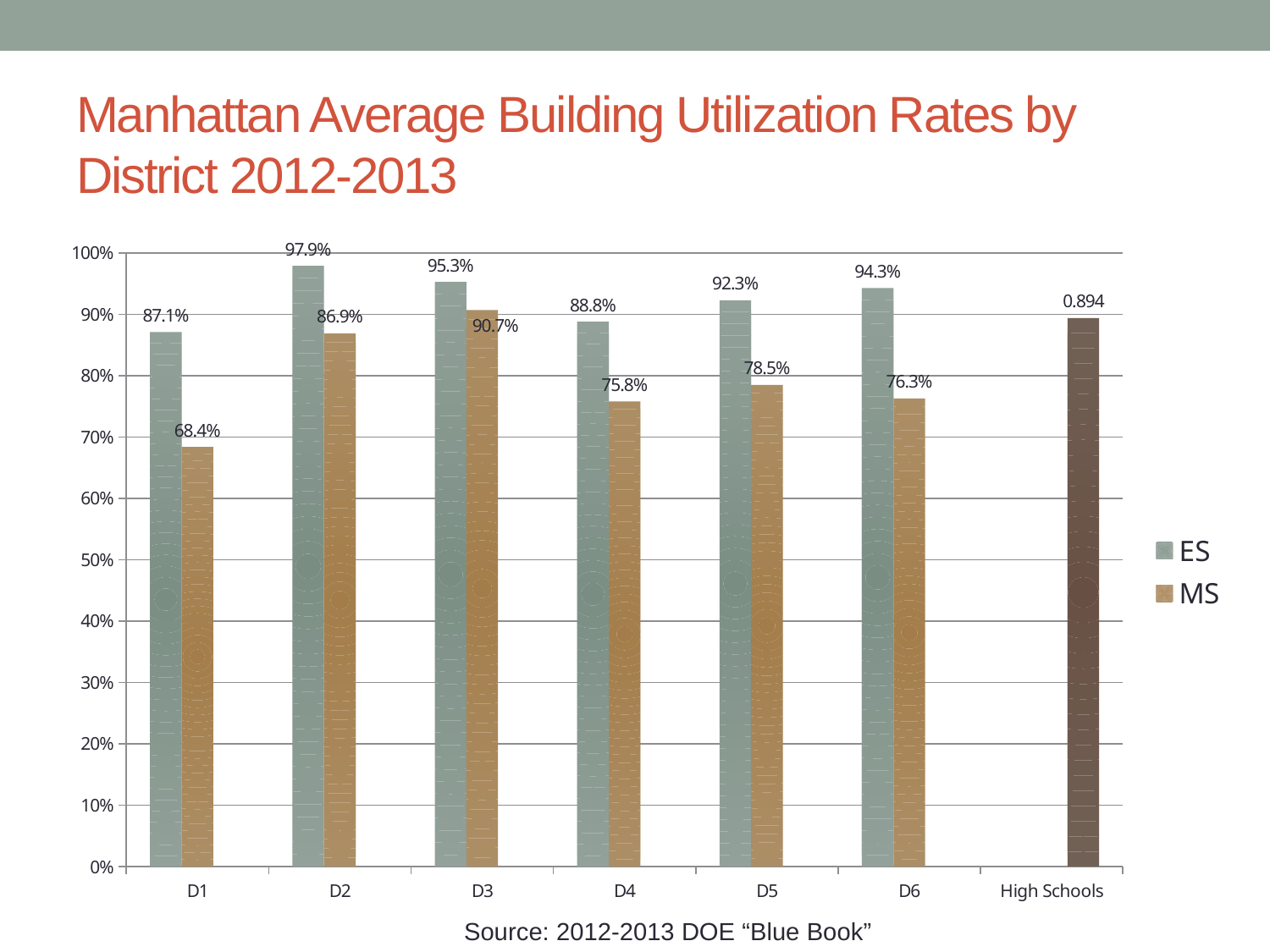
What kind of chart is shown on the slide? bar chart Which is larger, the MS value for D5 or the MS value for D6? D5 What is the MS value for D1? 68.4% What is the ES value for D2? 97.9% What value is labeled on the High Schools bar? 0.894 How many series does the legend list? 2 What is the difference between the ES and MS values for D1? 18.7% Is the MS value for D4 greater or less than 80%? less Which district has the lowest MS value? D1 What is the MS value for D3? 90.7% Which district has the highest ES value? D2 How many categories are shown on the x axis? 7